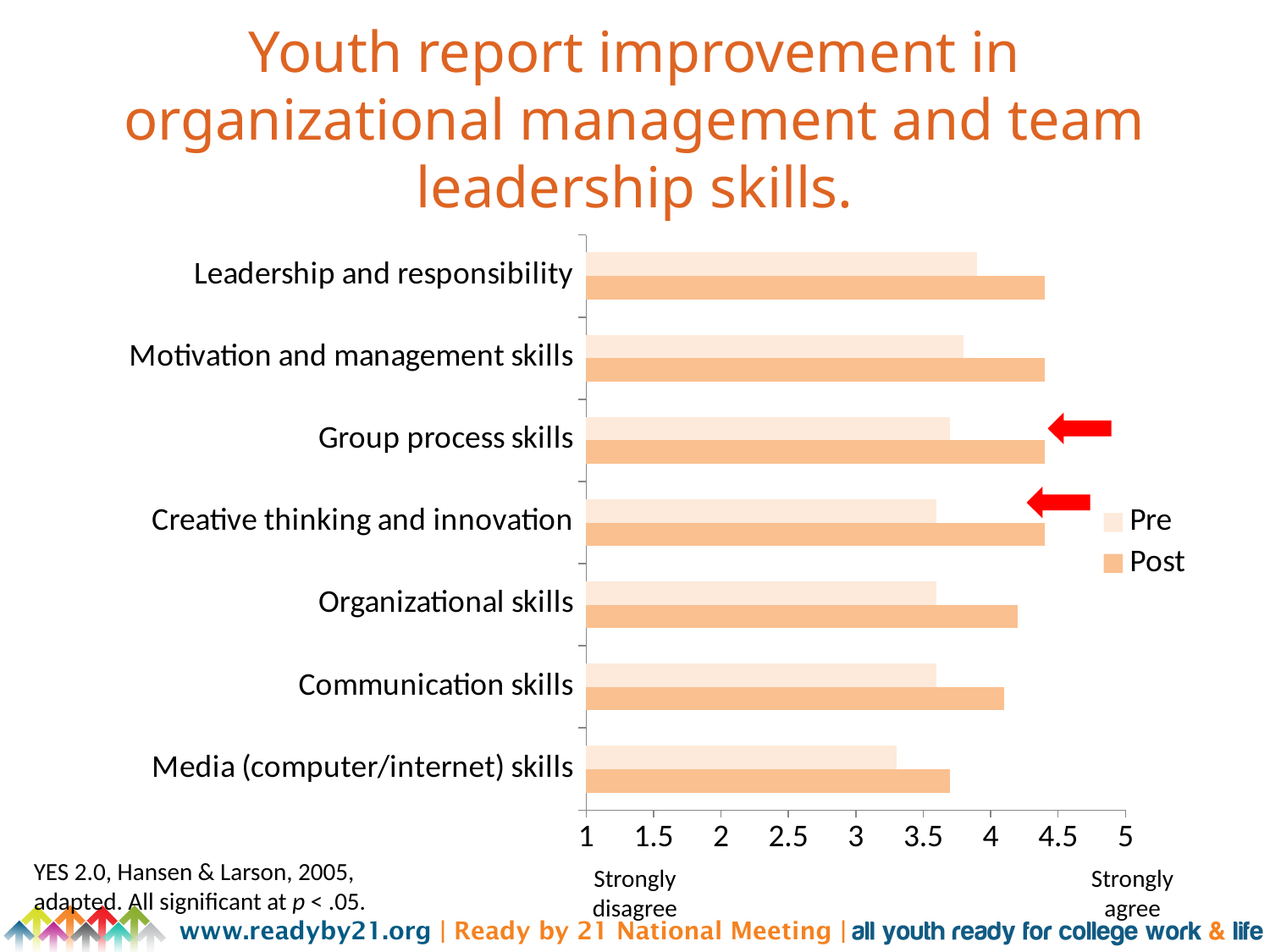
Is the Post value for Leadership and responsibility greater or less than 4? greater How many series does the legend list? 2 Is the Post value for Media (computer/internet) skills greater or less than 3.5? greater What are the two series named in the legend? Pre and Post Is the Pre value for Media (computer/internet) skills greater or less than 3.5? less What kind of chart is shown on the slide? bar chart Which category has the lowest Post value? Media (computer/internet) skills How many skill categories are plotted on the chart? 7 For Creative thinking and innovation, which is larger, the Pre value or the Post value? Post What label is shown at the right end of the x axis, under the value 5? Strongly agree Which category has the lowest Pre value? Media (computer/internet) skills